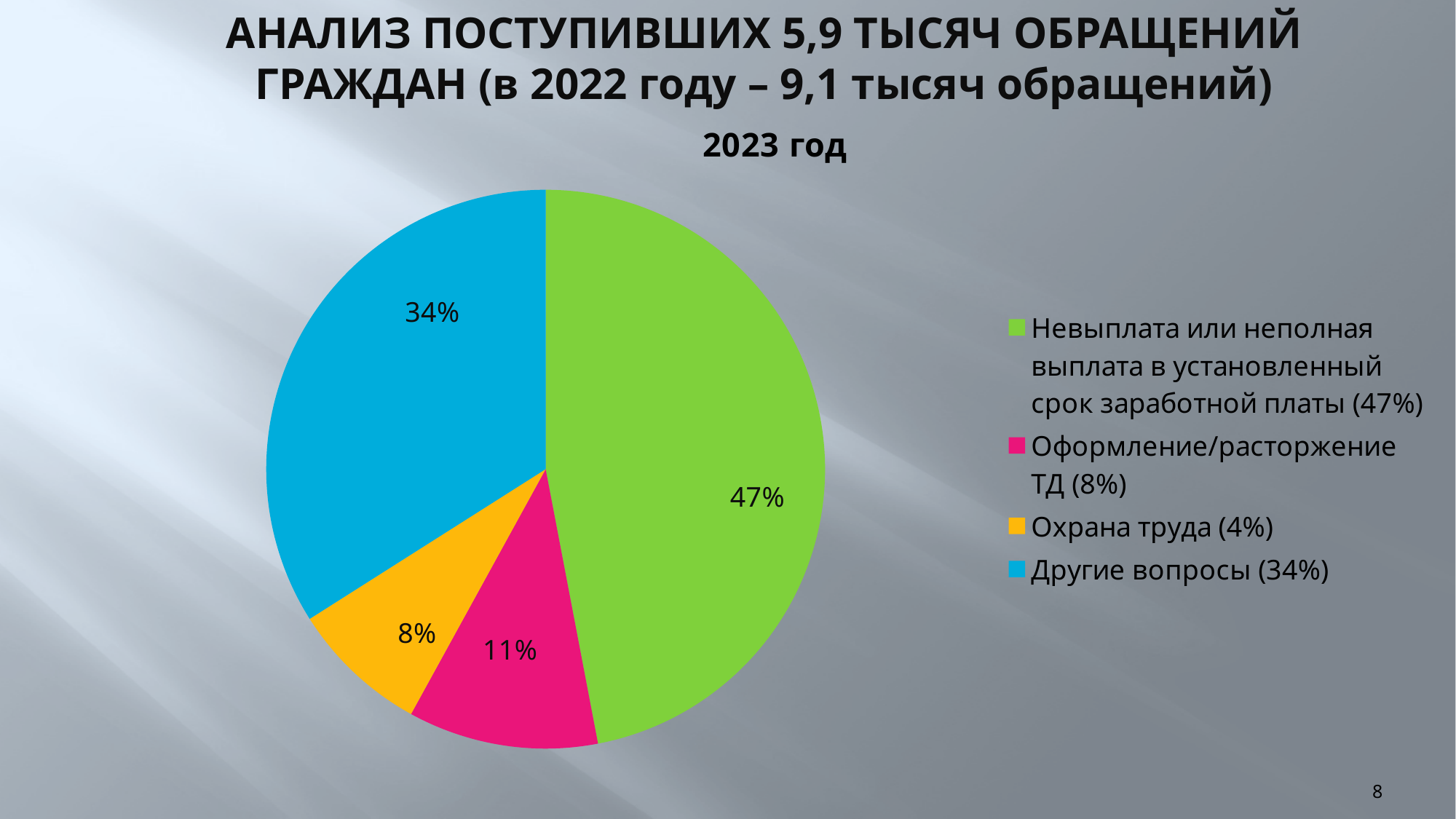
How many entries does the legend list? 4 What is the difference in percentage points between the 'Невыплата или неполная выплата в установленный срок заработной платы' slice (47%) and the 'Другие вопросы' slice (34%)? 13% Which category has the smallest slice of the pie? Охрана труда Which category has the largest slice of the pie? Невыплата или неполная выплата в установленный срок заработной платы What colour is the slice for 'Другие вопросы'? blue What share of the pie is labelled for 'Другие вопросы'? 34% What data label is printed on the pink slice of the pie? 11% How many slices does the pie chart have? 4 What type of chart is shown on the slide? pie chart What is the title of the chart? 2023 год Which is larger: the slice for 'Невыплата или неполная выплата в установленный срок заработной платы' or the slice for 'Другие вопросы'? Невыплата или неполная выплата в установленный срок заработной платы What share of the pie is labelled for 'Невыплата или неполная выплата в установленный срок заработной платы'? 47%